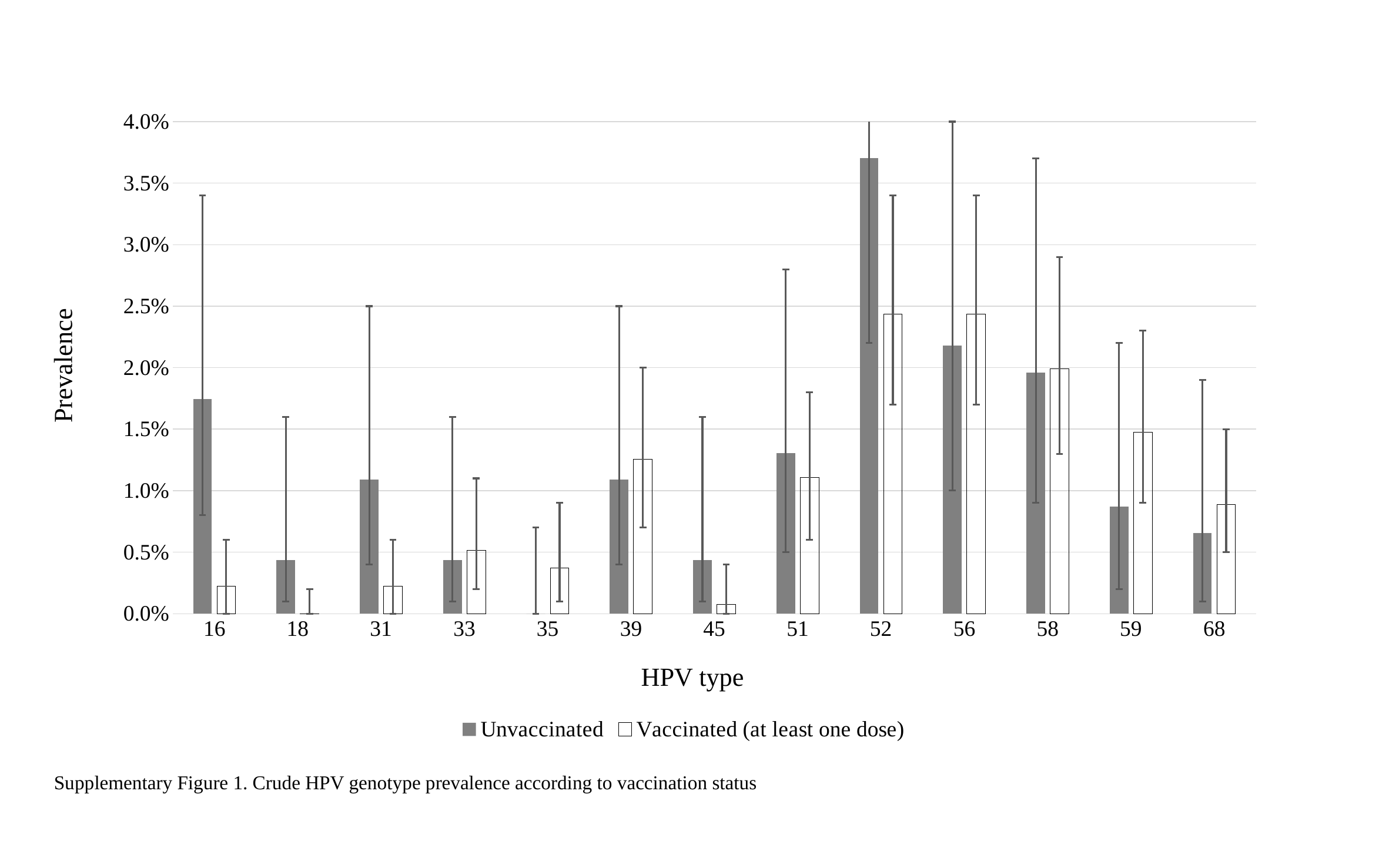
Is the Vaccinated (at least one dose) prevalence for HPV type 39 greater or less than 1.0%? greater How many series does the legend list? 2 Is the Unvaccinated prevalence for HPV type 16 greater or less than 1.5%? greater What is the label of the y axis? Prevalence Is the Unvaccinated prevalence for HPV type 52 greater or less than 3.5%? greater For HPV type 59, which group has the higher prevalence, Unvaccinated or Vaccinated (at least one dose)? Vaccinated (at least one dose) What kind of chart is shown on the slide? bar chart Which HPV type has the highest Unvaccinated prevalence? 52 For HPV type 16, which group has the higher prevalence, Unvaccinated or Vaccinated (at least one dose)? Unvaccinated Which HPV type has the lowest Unvaccinated prevalence? 35 How many HPV types are shown on the x axis? 13